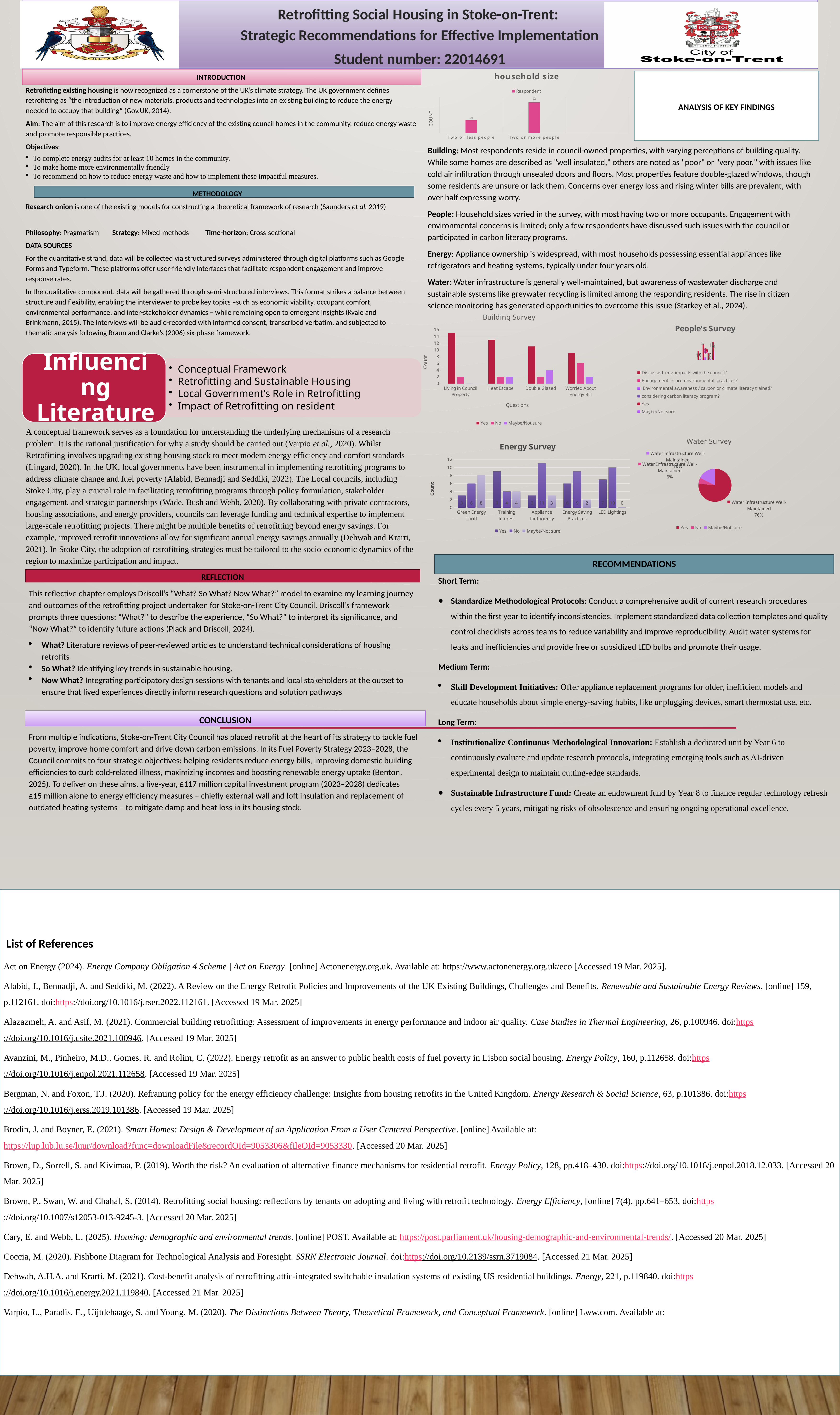
In the Energy Survey chart, what is the 'No' value for Appliance Inefficiency? 11 What kind of chart is the Water Survey chart? pie chart In the Building Survey chart, is the 'Yes' value for Living in Council Property greater or less than 12? greater How many series does the legend of the Building Survey chart list? 3 In the household size chart, which category has the higher count: Two or less people or Two or more people? Two or more people How many categories are shown on the x axis of the Energy Survey chart? 5 In the Energy Survey chart, what is the 'Maybe/Not sure' value for LED Lightings? 0 How many question categories are shown on the x axis of the Building Survey chart? 4 In the Building Survey chart, which category has the highest 'Yes' count? Living in Council Property What kind of chart is the Building Survey chart? bar chart In the Building Survey chart, is the 'Yes' value for Worried About Energy Bill greater or less than 12? less In the Water Survey pie chart, what share does the largest slice have? 76%